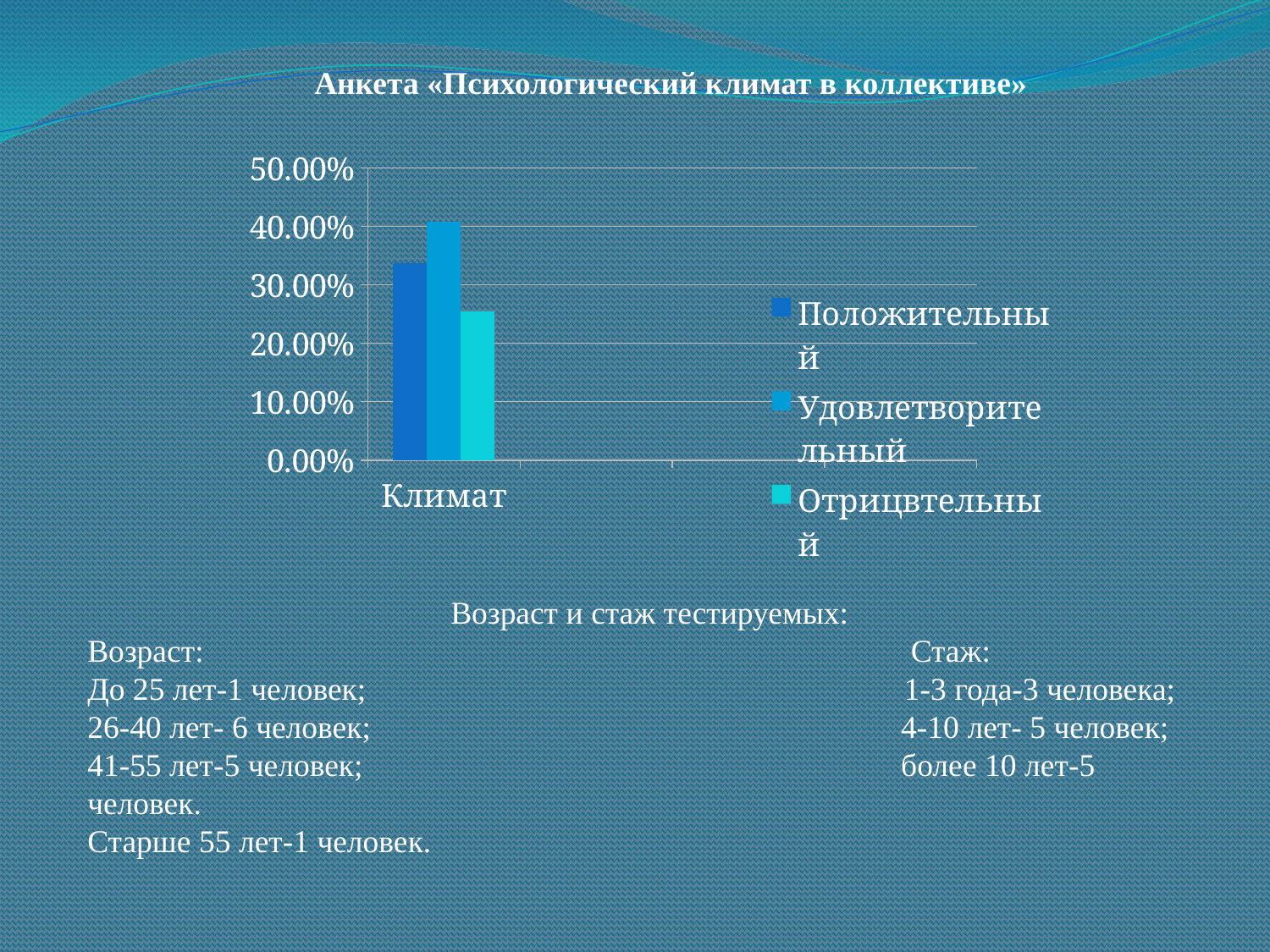
Which is larger, the value for Удовлетворительный or the value for Положительный? Удовлетворительный Is the value for Удовлетворительный greater or less than 30.00%? greater What is the highest value shown on the y axis? 50.00% What is the name of the category on the x axis? Климат How many categories are shown on the x axis? 1 What kind of chart is shown on the slide? bar chart Is the value for Положительный greater or less than 30.00%? greater How many series does the legend list? 3 Which is larger, the value for Положительный or the value for Отрицвтельный? Положительный Is the value for Отрицвтельный greater or less than 30.00%? less Which series has the lowest bar? Отрицвтельный Which series has the highest bar? Удовлетворительный